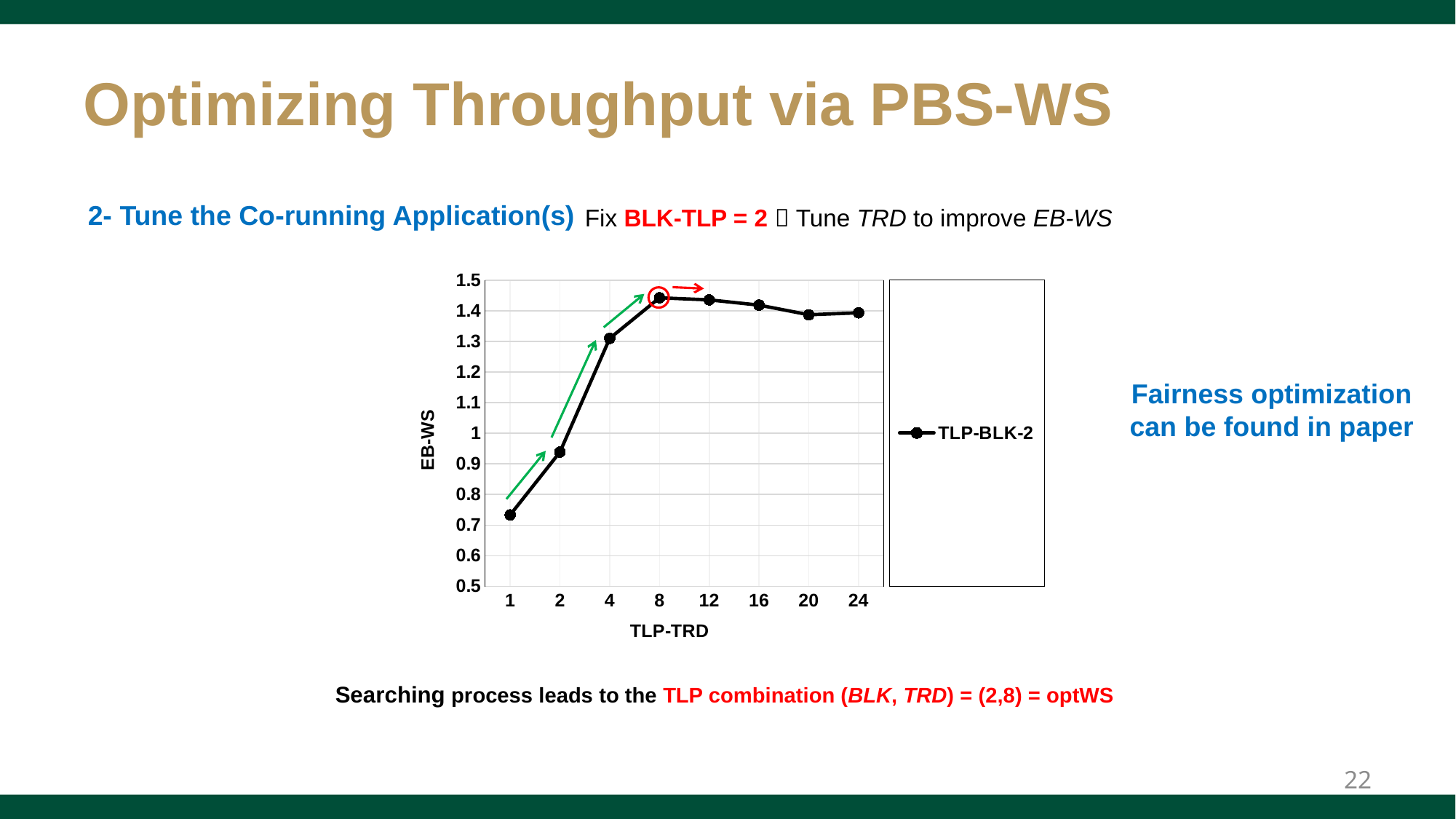
What kind of chart is shown on the slide? line chart Is the EB-WS value for TLP-TRD = 2 greater or less than 1? less Does EB-WS rise or fall as TLP-TRD increases from 1 to 8? rise Which TLP-TRD value has the lowest EB-WS? 1 How many series does the legend list? 1 How many TLP-TRD values are plotted on the x axis? 8 Is the EB-WS value for TLP-TRD = 1 greater or less than 0.8? less Is the EB-WS value for TLP-TRD = 4 greater or less than 1.2? greater What is the name of the series in the legend? TLP-BLK-2 What is the label of the y axis? EB-WS Which has a higher EB-WS value, TLP-TRD = 2 or TLP-TRD = 4? TLP-TRD = 4